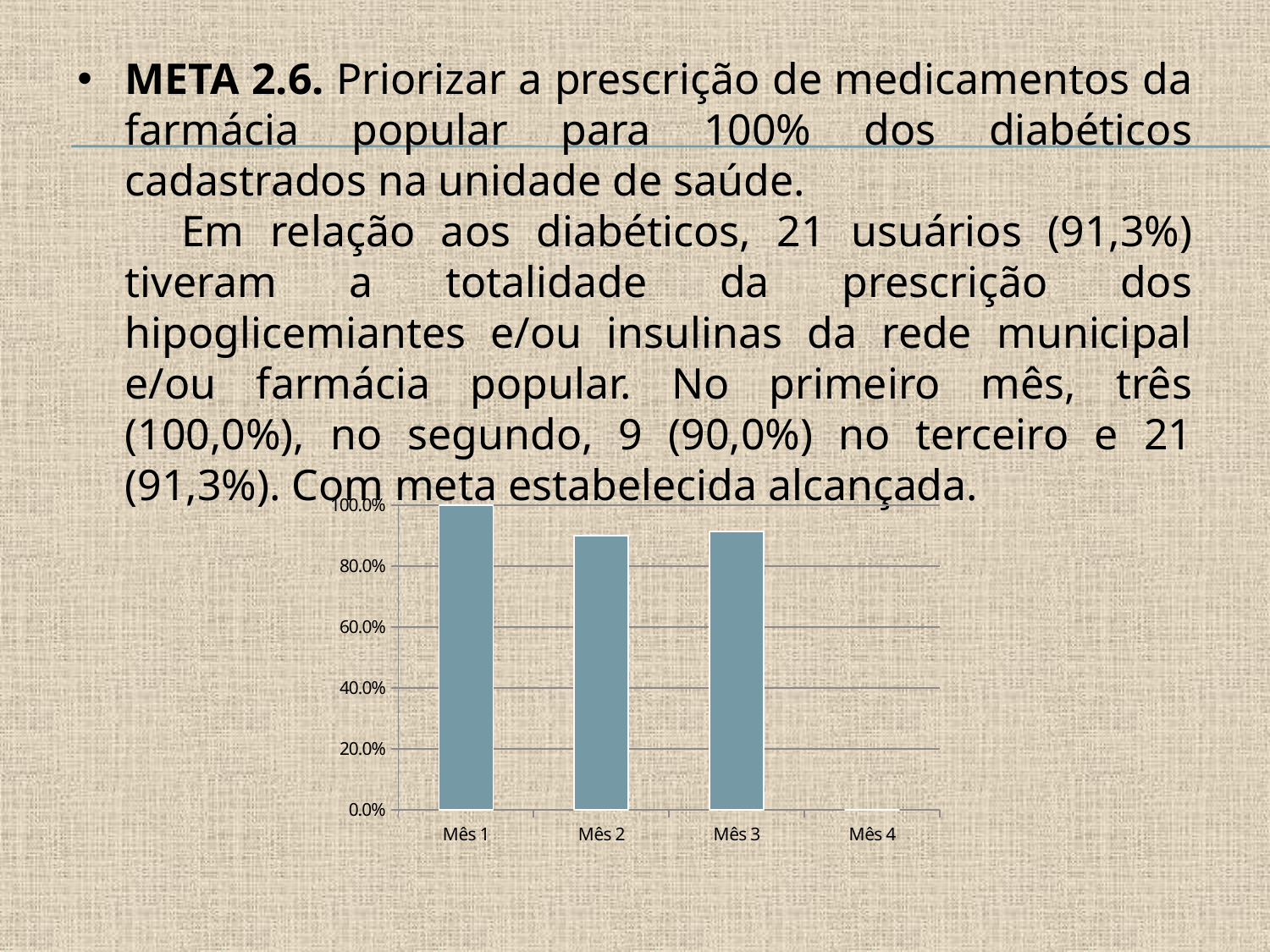
Is the value for Mês 3 greater or less than 80.0%? greater How many categories are shown on the x axis of the chart? 4 Does the value rise or fall from Mês 1 to Mês 2? fall What is the highest value shown on the y axis of the chart? 100.0% What is the value for Mês 1 in the chart? 100.0% Which category has the highest value in the chart? Mês 1 Which is larger, the value for Mês 3 or the value for Mês 4? Mês 3 Is the value for Mês 2 greater or less than 80.0%? greater Is the value for Mês 2 greater or less than 100.0%? less Which category has the lowest value in the chart? Mês 4 Which is larger, the value for Mês 1 or the value for Mês 2? Mês 1 What kind of chart is shown on the slide? bar chart